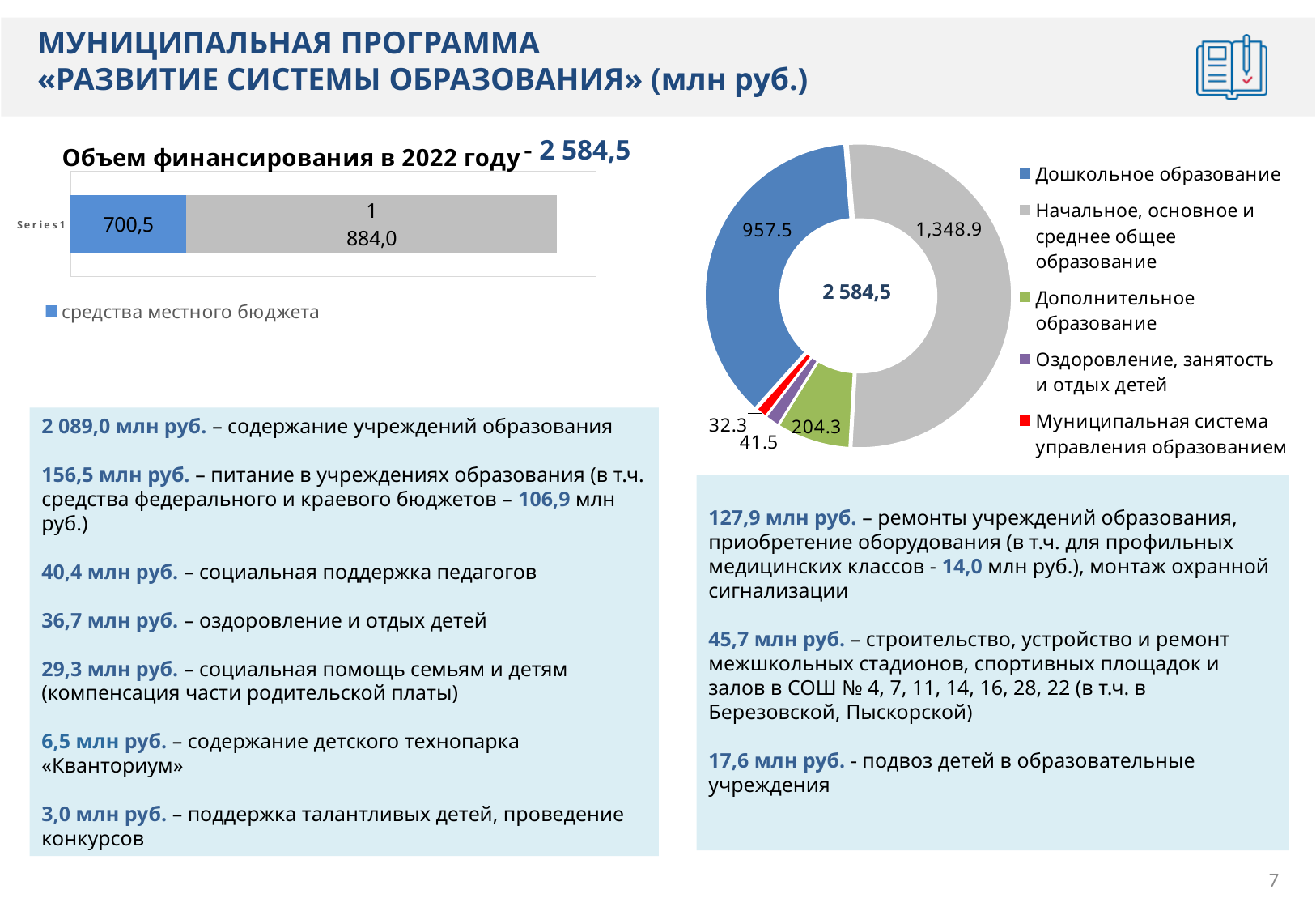
On the doughnut chart, which category has the largest value? Начальное, основное и среднее общее образование On the doughnut chart, how many categories does the legend list? 5 On the chart titled 'Объем финансирования в 2022 году', what is the value of the grey segment? 1 884,0 On the doughnut chart, what is the value for Начальное, основное и среднее общее образование? 1,348.9 On the doughnut chart, what is the value for Дополнительное образование? 204.3 On the doughnut chart, which category has the smallest value? Муниципальная система управления образованием On the doughnut chart, what is the value for Муниципальная система управления образованием? 32.3 On the doughnut chart, what is the difference between Начальное, основное и среднее общее образование and Дошкольное образование? 391.4 On the doughnut chart, what total is shown in the centre? 2 584,5 What kind of chart is the one titled 'Объем финансирования в 2022 году'? bar chart On the chart titled 'Объем финансирования в 2022 году', what is the value of the blue segment (средства местного бюджета)? 700,5 On the doughnut chart, what is the value for Дошкольное образование? 957.5